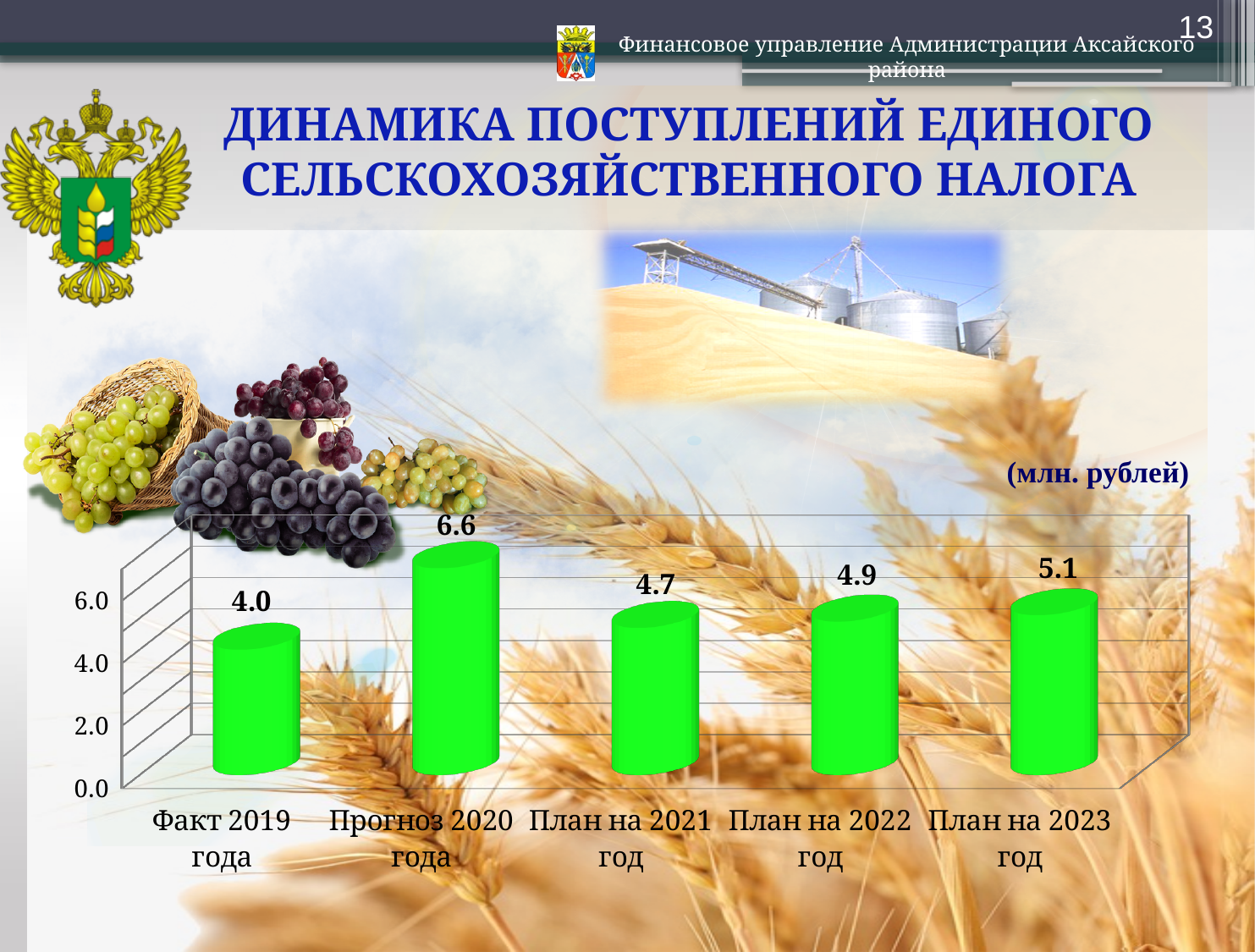
Do the values rise or fall from План на 2021 год to План на 2023 год? rise What is the difference between the values for План на 2023 год and План на 2021 год? 0.4 What kind of chart is shown on the slide? bar chart Which category has the highest value? Прогноз 2020 года What is the value for План на 2023 год? 5.1 What is the value for Факт 2019 года? 4.0 How many categories are shown on the chart? 5 What is the difference between the values for Прогноз 2020 года and Факт 2019 года? 2.6 Which category has the lowest value? Факт 2019 года What is the value for Прогноз 2020 года? 6.6 Which is larger, the value for План на 2022 год or the value for План на 2021 год? План на 2022 год Is the value for Прогноз 2020 года greater or less than 6.0? greater